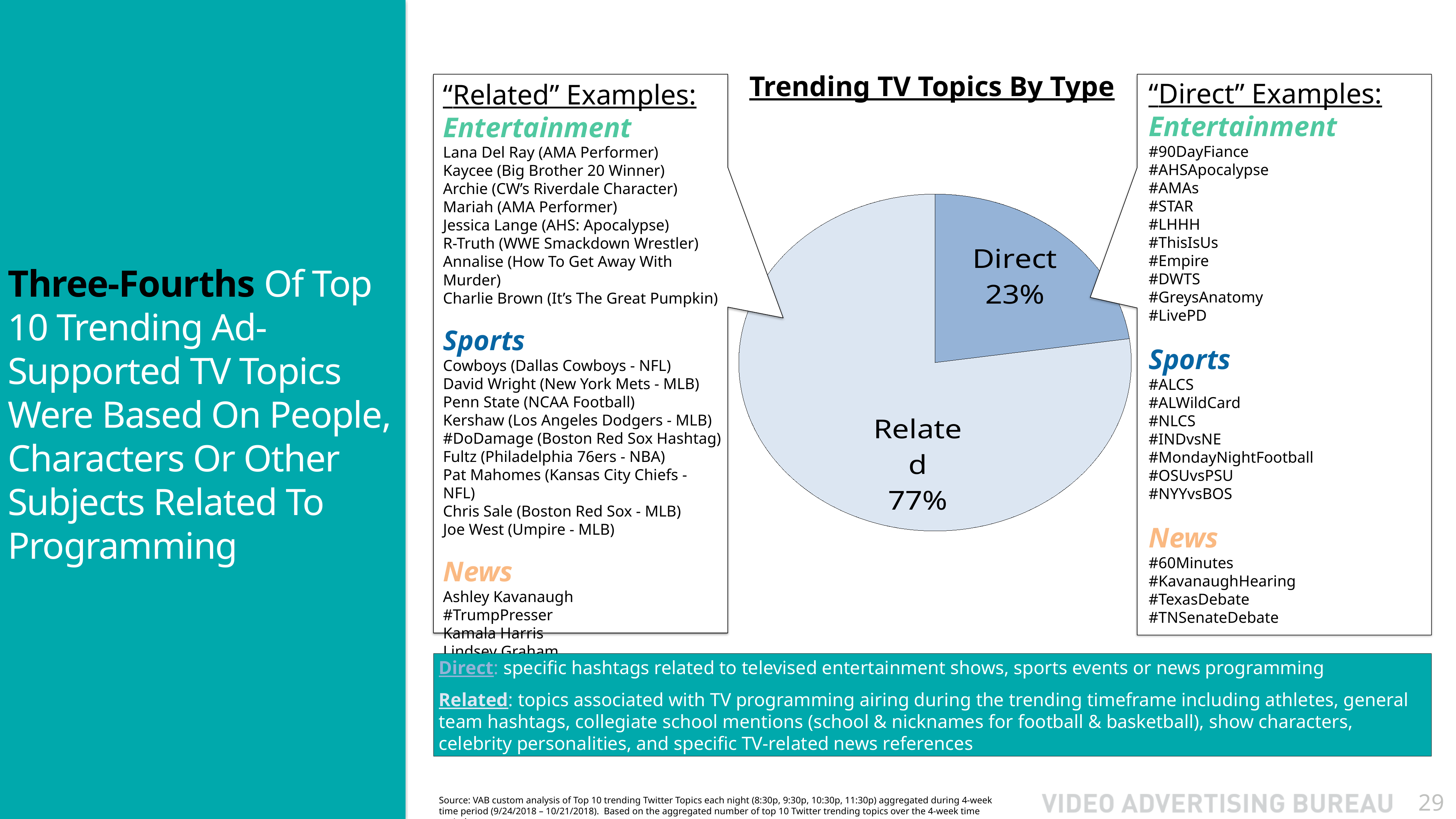
Is the Direct share greater or less than 50%? less What kind of chart is shown on the slide? pie chart What share of trending TV topics is Direct? 23% Which is larger, the Direct slice or the Related slice? Related What is the title of the chart? Trending TV Topics By Type Which slice of the pie is the smallest? Direct Which slice of the pie is shaded in the darker blue? Direct How many slices does the pie chart have? 2 What is the difference in percentage points between the Related and Direct slices? 54 What share of trending TV topics is Related? 77% Which slice of the pie is the largest? Related